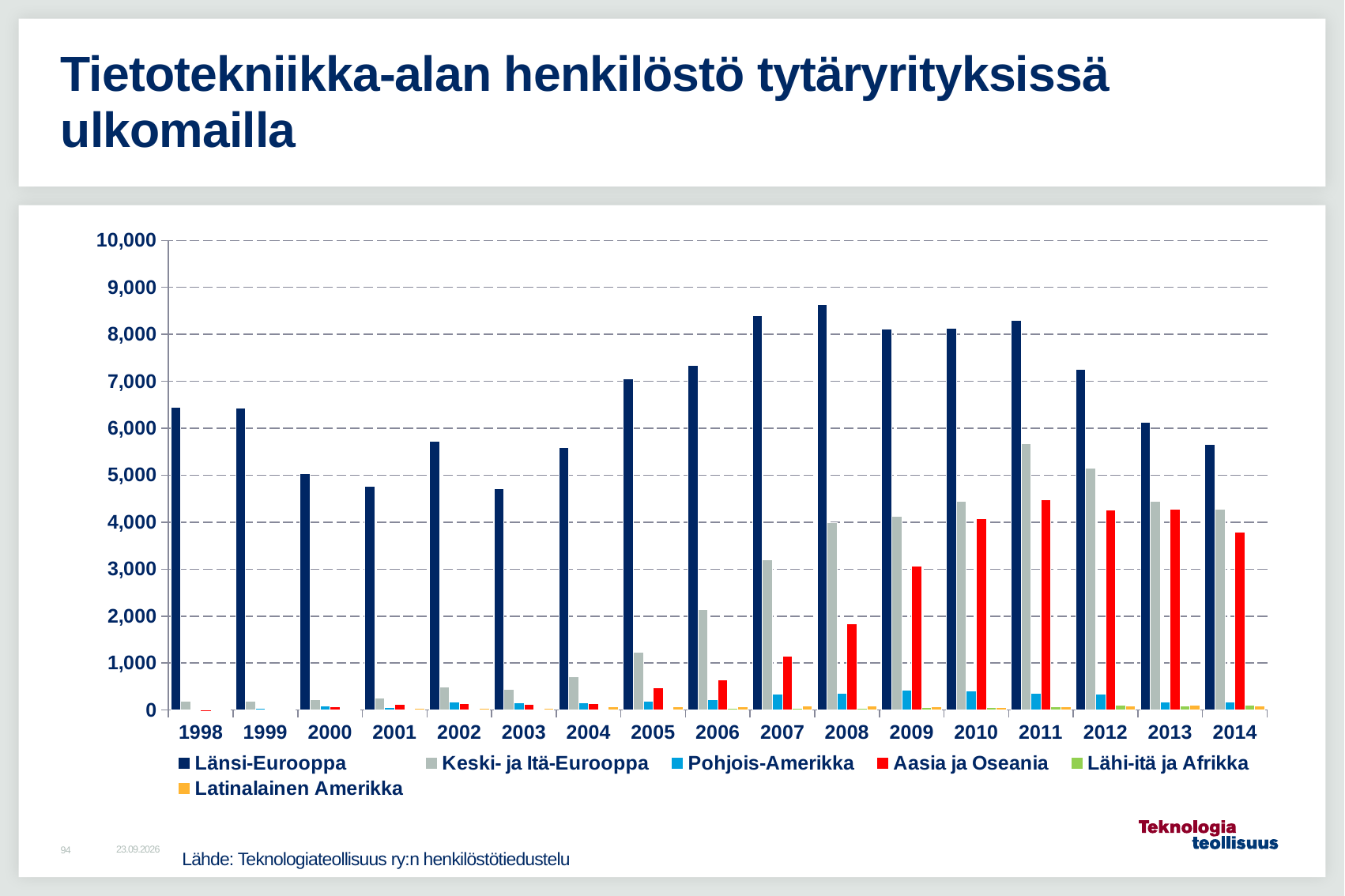
Do the values for Aasia ja Oseania rise or fall from 2005 to 2011? rise In which year is the value for Länsi-Eurooppa highest? 2008 Is the value for Keski- ja Itä-Eurooppa in 2007 greater or less than 3,000? greater How many series does the legend list? 6 Is the value for Aasia ja Oseania in 2011 greater or less than 4,000? greater Is the value for Länsi-Eurooppa in 2008 greater or less than 8,000? greater What kind of chart is shown on the slide? bar chart In which year is the value for Keski- ja Itä-Eurooppa highest? 2011 How many years are shown on the x axis? 17 In 2014, which is larger: Keski- ja Itä-Eurooppa or Aasia ja Oseania? Keski- ja Itä-Eurooppa What colour are the bars for Aasia ja Oseania? red